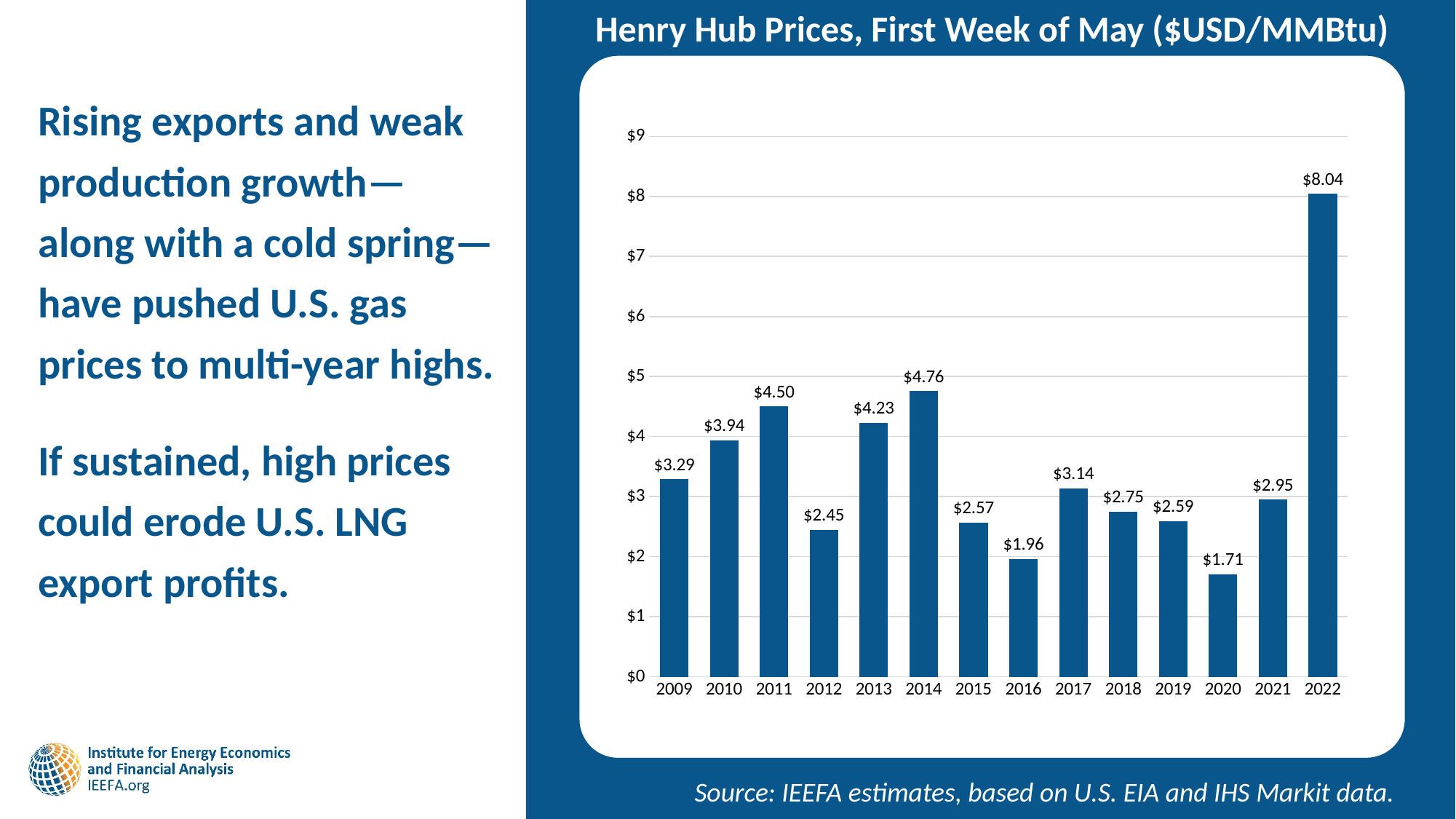
Is the Henry Hub price for 2017 greater or less than $3? greater Which year had a higher Henry Hub price, 2011 or 2013? 2011 What was the Henry Hub price in the first week of May 2016? $1.96 What was the Henry Hub price in the first week of May 2014? $4.76 What is the title of the chart? Henry Hub Prices, First Week of May ($USD/MMBtu) What is the difference between the 2022 and 2021 Henry Hub prices? $5.09 How many years are shown in the chart? 14 Which year has the lowest Henry Hub price in the chart? 2020 What is the difference between the 2014 and 2015 Henry Hub prices? $2.19 Which year has the highest Henry Hub price in the chart? 2022 What was the Henry Hub price in the first week of May 2022? $8.04 What kind of chart is used to show Henry Hub prices? Bar chart